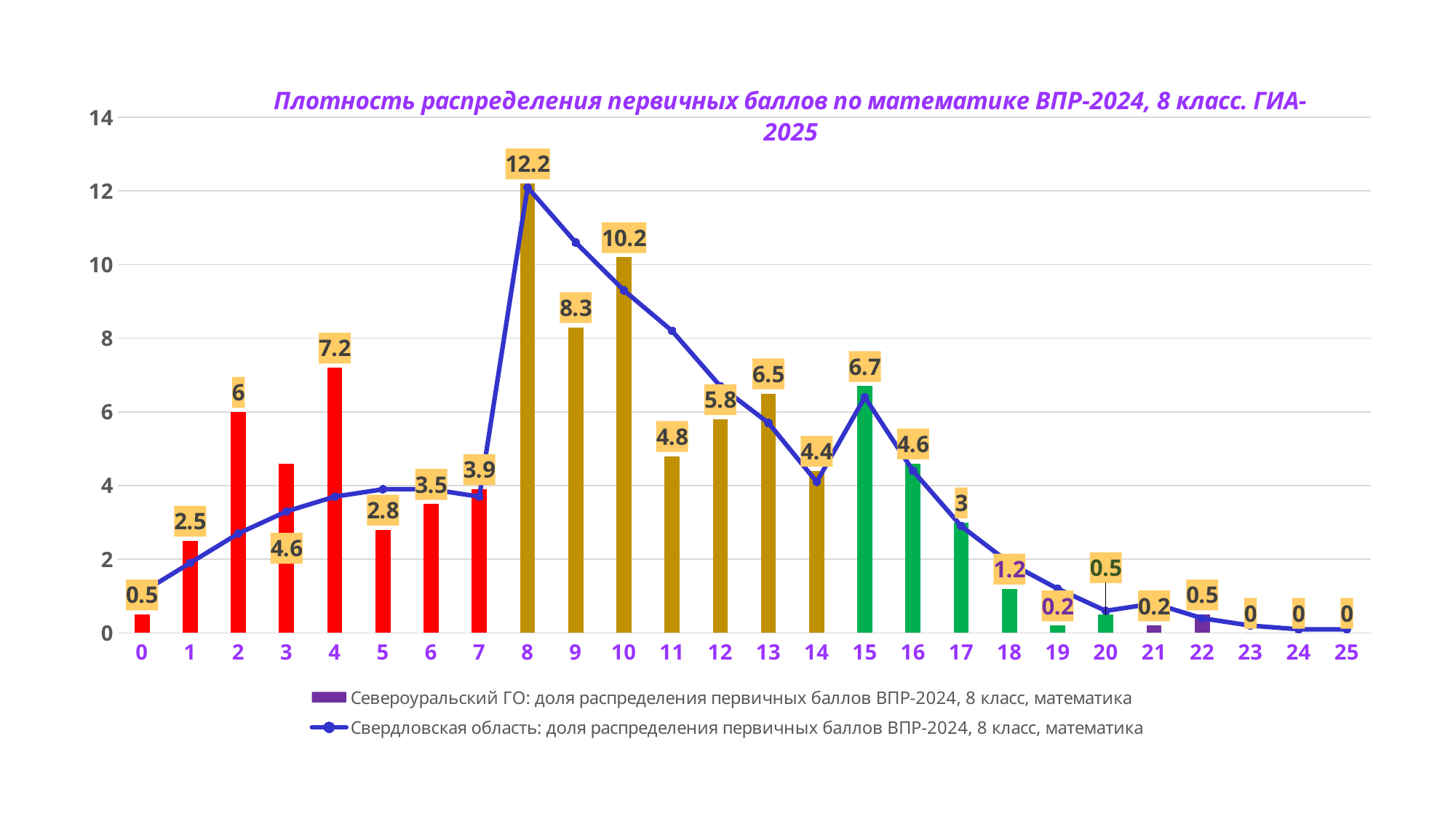
What is the value of the Североуральский ГО bar for score 15? 6.7 What is the value of the Североуральский ГО bar for score 8? 12.2 Which Североуральский ГО bar is larger: score 2 or score 3? score 2 What is the value of the Североуральский ГО bar for score 4? 7.2 Do the Североуральский ГО bars rise or fall from score 15 to score 19? fall How many score categories are shown on the x axis? 26 Is the Свердловская область line value at score 8 greater or less than 10? greater Which series is drawn as a line with markers? Свердловская область: доля распределения первичных баллов ВПР-2024, 8 класс, математика Is the Свердловская область line value at score 0 greater or less than 2? less How many series does the legend list? 2 What is the difference between the Североуральский ГО bars for scores 8 and 10? 2 Which score has the highest Североуральский ГО bar? 8